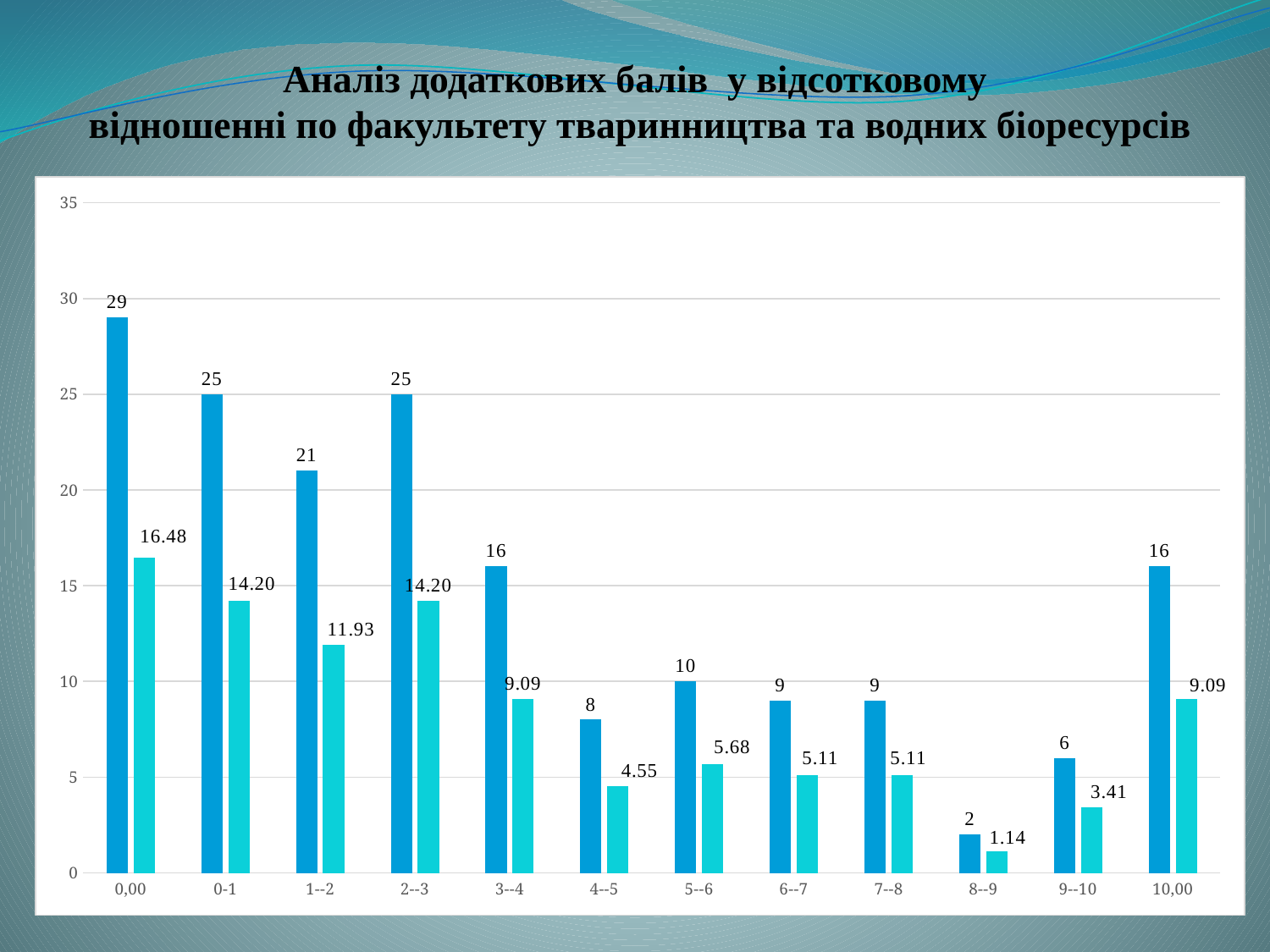
What is the difference between the dark blue bar values for 0,00 and 0-1? 4 What kind of chart is shown on the slide? Bar chart What is the value of the dark blue bar for the category 10,00? 16 Which category has the lowest light blue bar? 8--9 Which is larger: the light blue bar for 3--4 or the light blue bar for 5--6? 3--4 What is the value of the light blue bar for the category 1--2? 11.93 Which category has the highest dark blue bar? 0,00 Is the dark blue bar for 2--3 greater or less than 20? greater What is the value of the light blue bar for the category 9--10? 3.41 How many categories are shown on the x axis? 12 Do the dark blue bar values rise or fall from 5--6 to 8--9? Fall What is the value of the dark blue bar for the category 0,00? 29